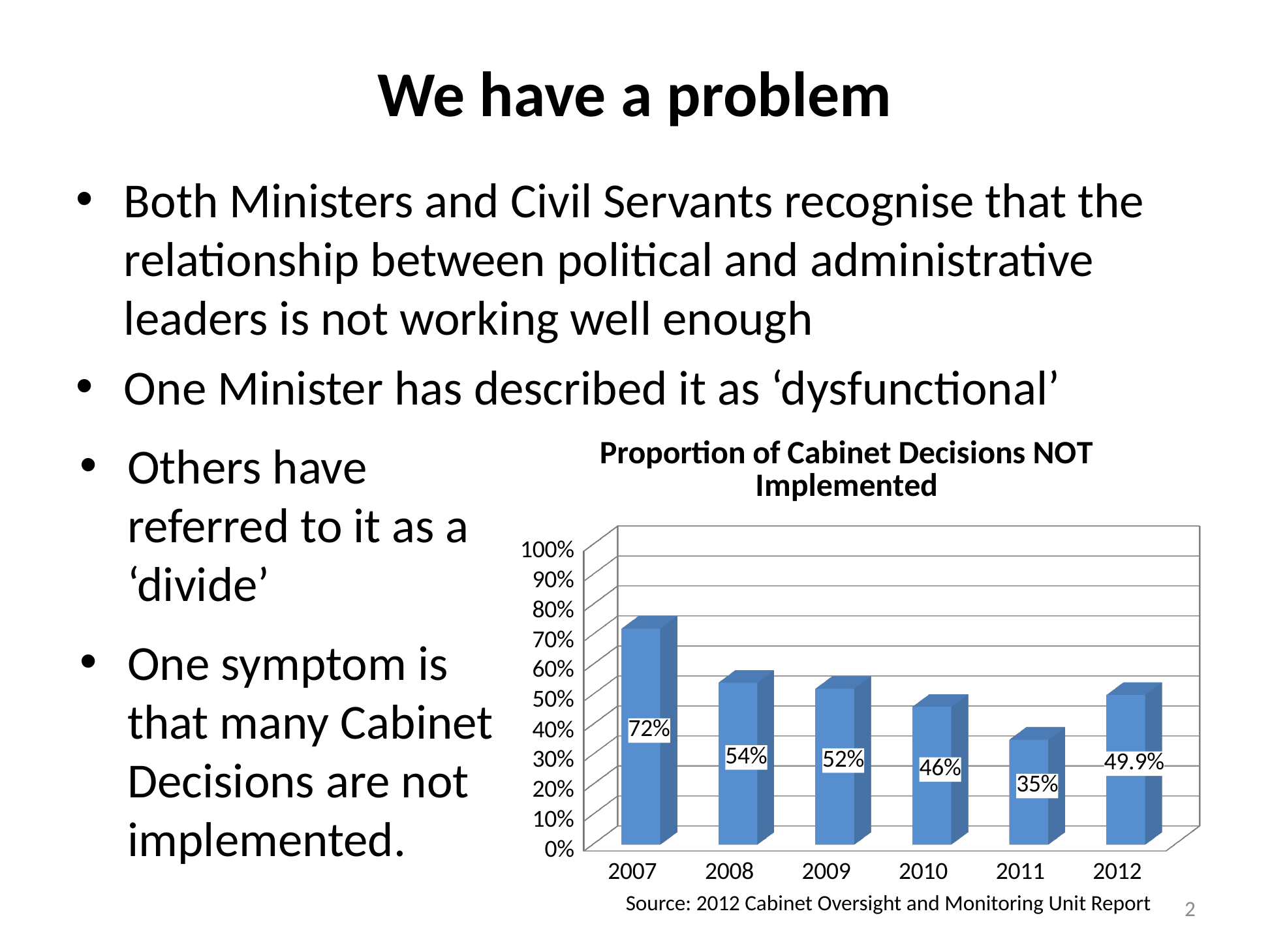
What is the proportion of Cabinet decisions not implemented in 2007? 72% What kind of chart is shown on the slide? bar chart Which year has the highest proportion of Cabinet decisions not implemented? 2007 What is the title of the chart? Proportion of Cabinet Decisions NOT Implemented Which year has the lowest proportion of Cabinet decisions not implemented? 2011 How many years are shown on the x axis of the chart? 6 What is the value shown for 2010? 46% Which year has a larger value, 2010 or 2012? 2012 What is the difference between the values for 2008 and 2009? 2% What is the difference between the values for 2007 and 2011? 37% What is the value shown for 2012? 49.9% Is the value for 2011 greater or less than 40%? less